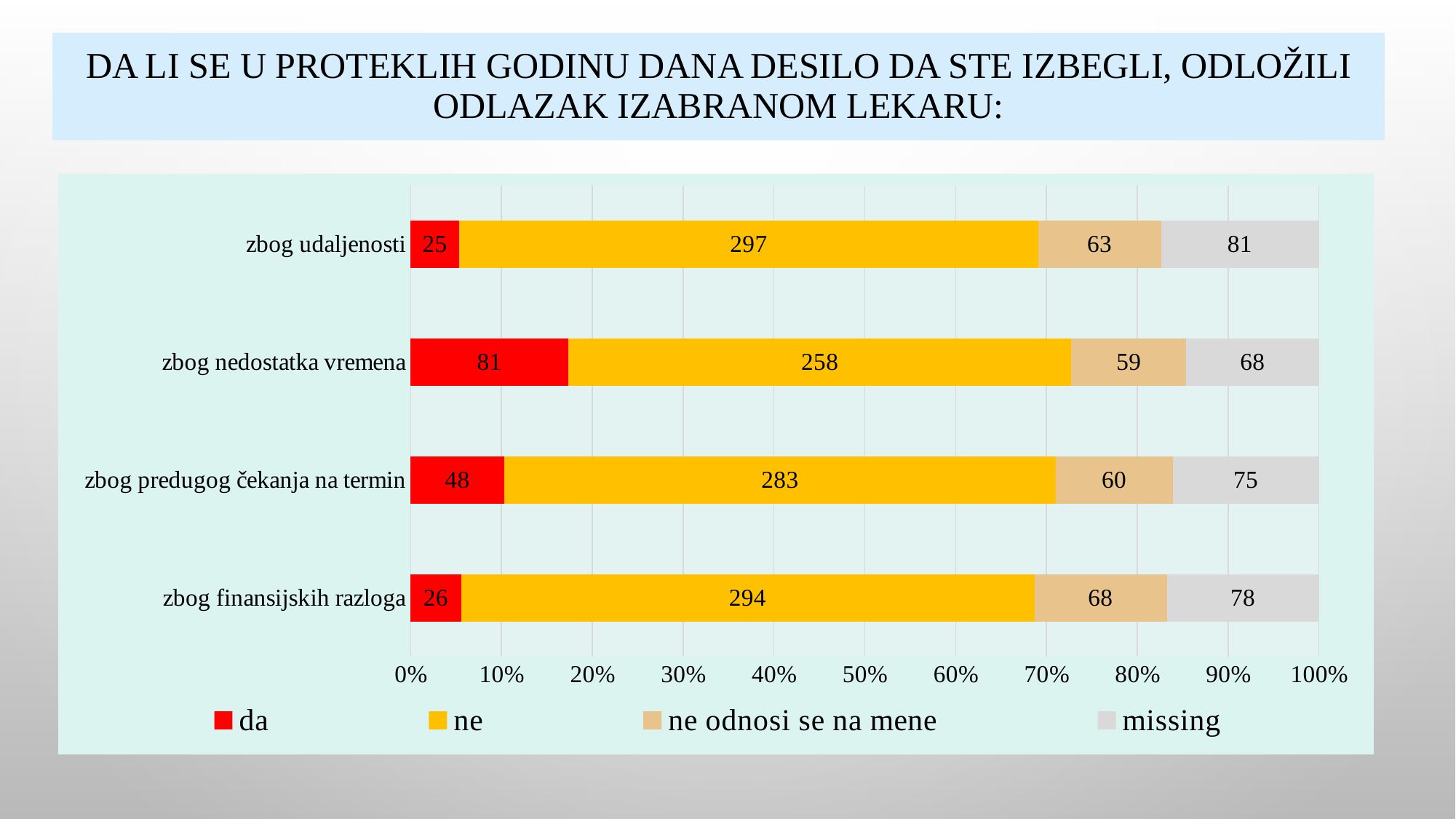
How many series does the legend list? 4 What is the difference between the "ne" values for "zbog udaljenosti" and "zbog nedostatka vremena"? 39 Which category has the highest value for "da"? zbog nedostatka vremena What kind of chart is shown on the slide? Stacked bar chart How many categories are shown on the chart? 4 Which is larger: the "da" value for "zbog predugog čekanja na termin" or for "zbog finansijskih razloga"? zbog predugog čekanja na termin What is the value of "missing" for "zbog predugog čekanja na termin"? 75 What is the total of the stacked bar for "zbog udaljenosti"? 466 Which category has the lowest value for "ne"? zbog nedostatka vremena What is the value of "ne odnosi se na mene" for "zbog finansijskih razloga"? 68 What is the value of "da" for "zbog nedostatka vremena"? 81 What is the value of "ne" for "zbog udaljenosti"? 297